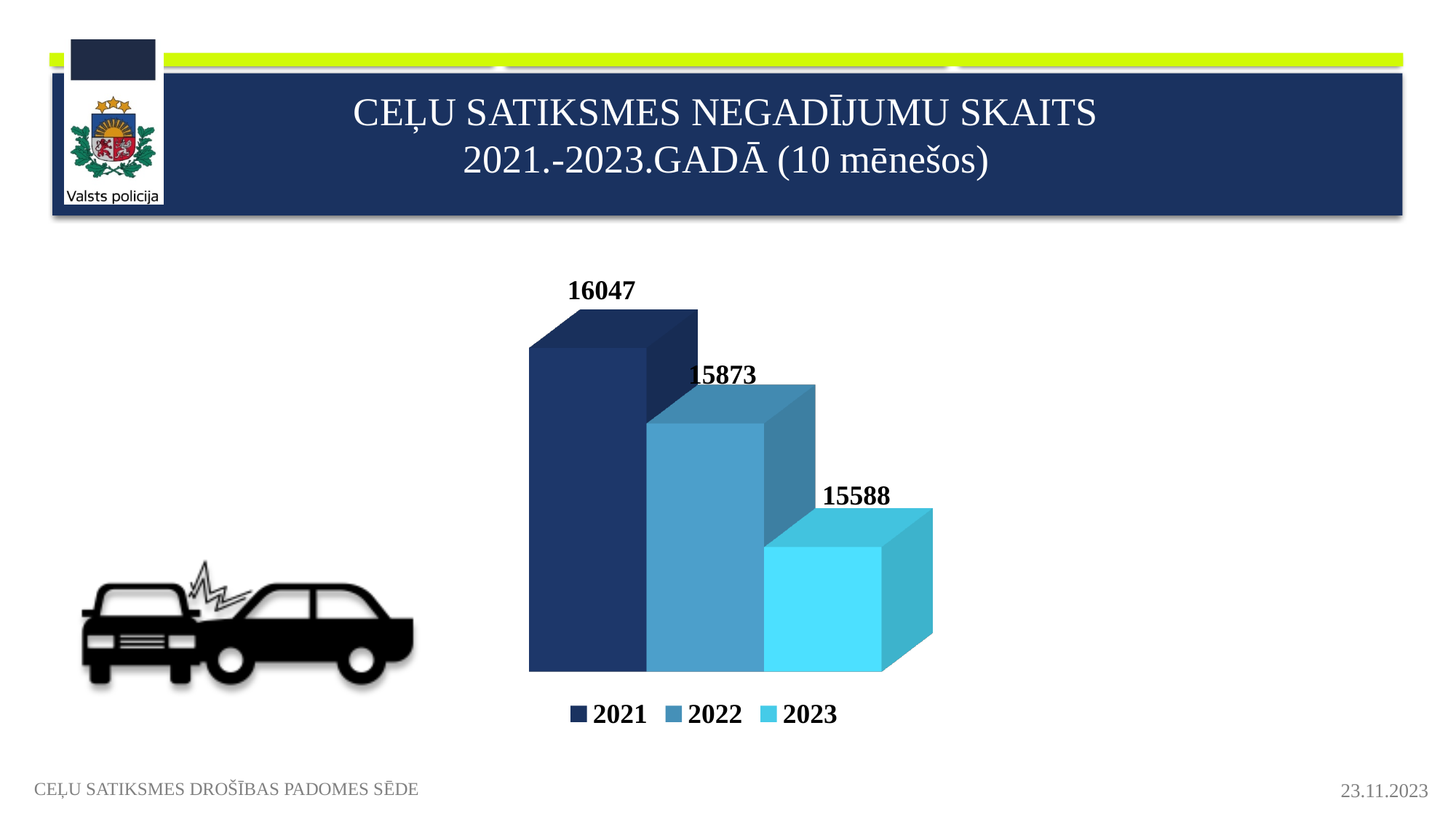
What is the value shown for 2021? 16047 What is the difference between the values for 2021 and 2023? 459 What is the value shown for 2023? 15588 Which year has the lowest value? 2023 What is the value shown for 2022? 15873 Which is larger, the value for 2022 or the value for 2023? 2022 What is the difference between the values for 2022 and 2023? 285 Which year has the highest value? 2021 What kind of chart is shown on the slide? bar chart Do the values rise or fall from 2021 to 2023? fall How many bars are plotted in the chart? 3 What is the difference between the values for 2021 and 2022? 174